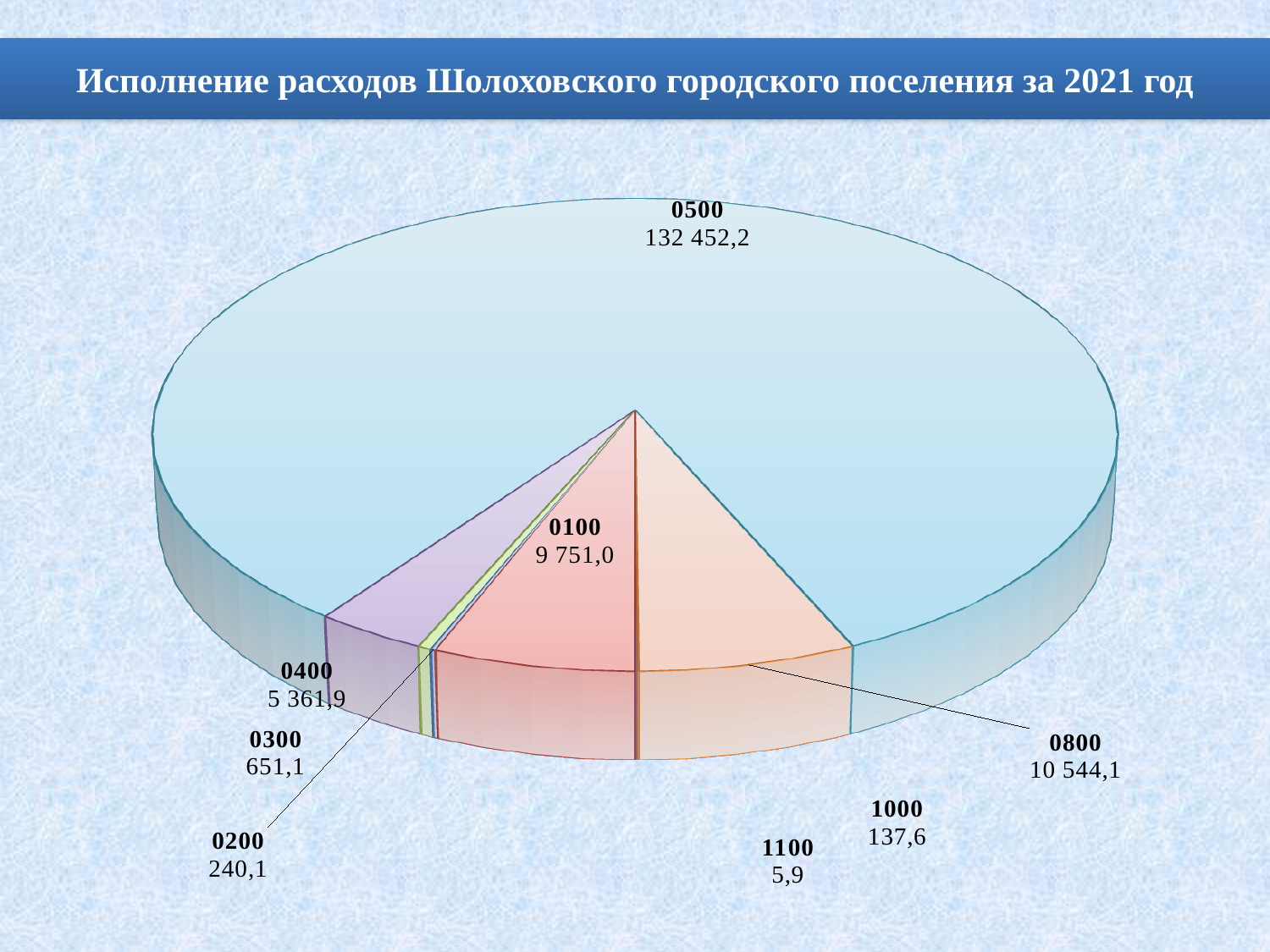
Which category has the largest value? 0500 What is the title of the slide? Исполнение расходов Шолоховского городского поселения за 2021 год What is the value for category 0800? 10 544,1 Which is larger, the value for 0800 or the value for 0100? 0800 What is the difference between the values for 0800 and 0100? 793,1 What is the difference between the values for 0400 and 0300? 4 710,8 What is the value for category 0100? 9 751,0 What is the value for category 1100? 5,9 Which category has the smallest value? 1100 How many categories are shown in the pie chart? 8 What is the value for category 0500? 132 452,2 What type of chart is shown on the slide? Pie chart